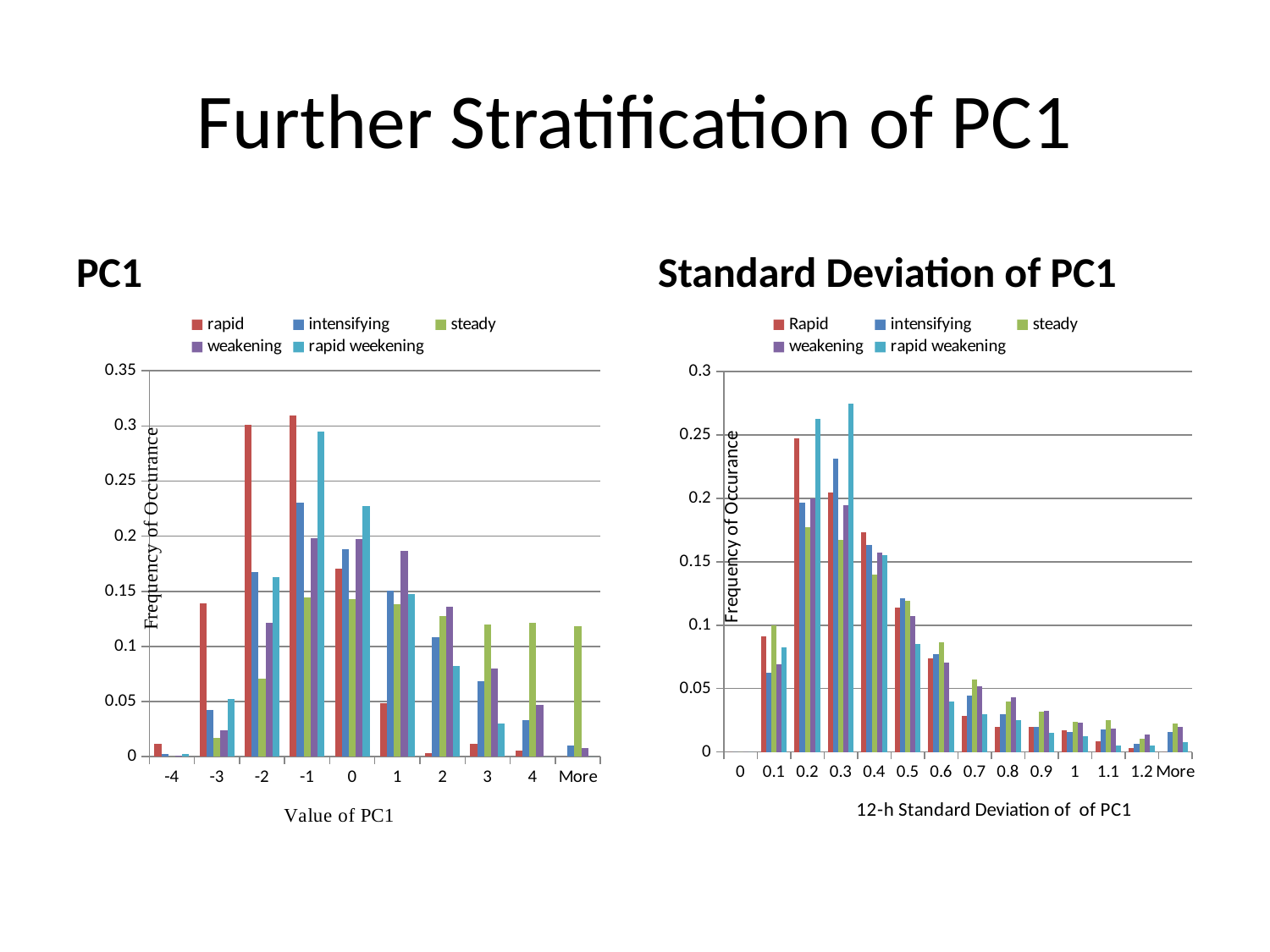
In the Standard Deviation of PC1 chart, do the values for Rapid rise or fall from 0.3 to 1.2 along the x axis? fall In the PC1 chart on the left, is the value for rapid weekening at 0 greater or less than 0.2? greater In the PC1 chart on the left, which series has the highest value at category 1? weakening In the Standard Deviation of PC1 chart, is the value for intensifying at 0.3 greater or less than 0.2? greater In the Standard Deviation of PC1 chart, is the value for rapid weekening at 0.3 greater or less than 0.25? greater What kind of chart is the PC1 chart on the left? bar chart In the Standard Deviation of PC1 chart, which series has the highest value at category 0.3? rapid weakening How many categories are shown on the x axis of the Standard Deviation of PC1 chart? 14 In the PC1 chart on the left, at category 0, which is larger: rapid or rapid weekening? rapid weekening How many series does the legend of the Standard Deviation of PC1 chart list? 5 How many categories are shown on the x axis of the PC1 chart on the left? 10